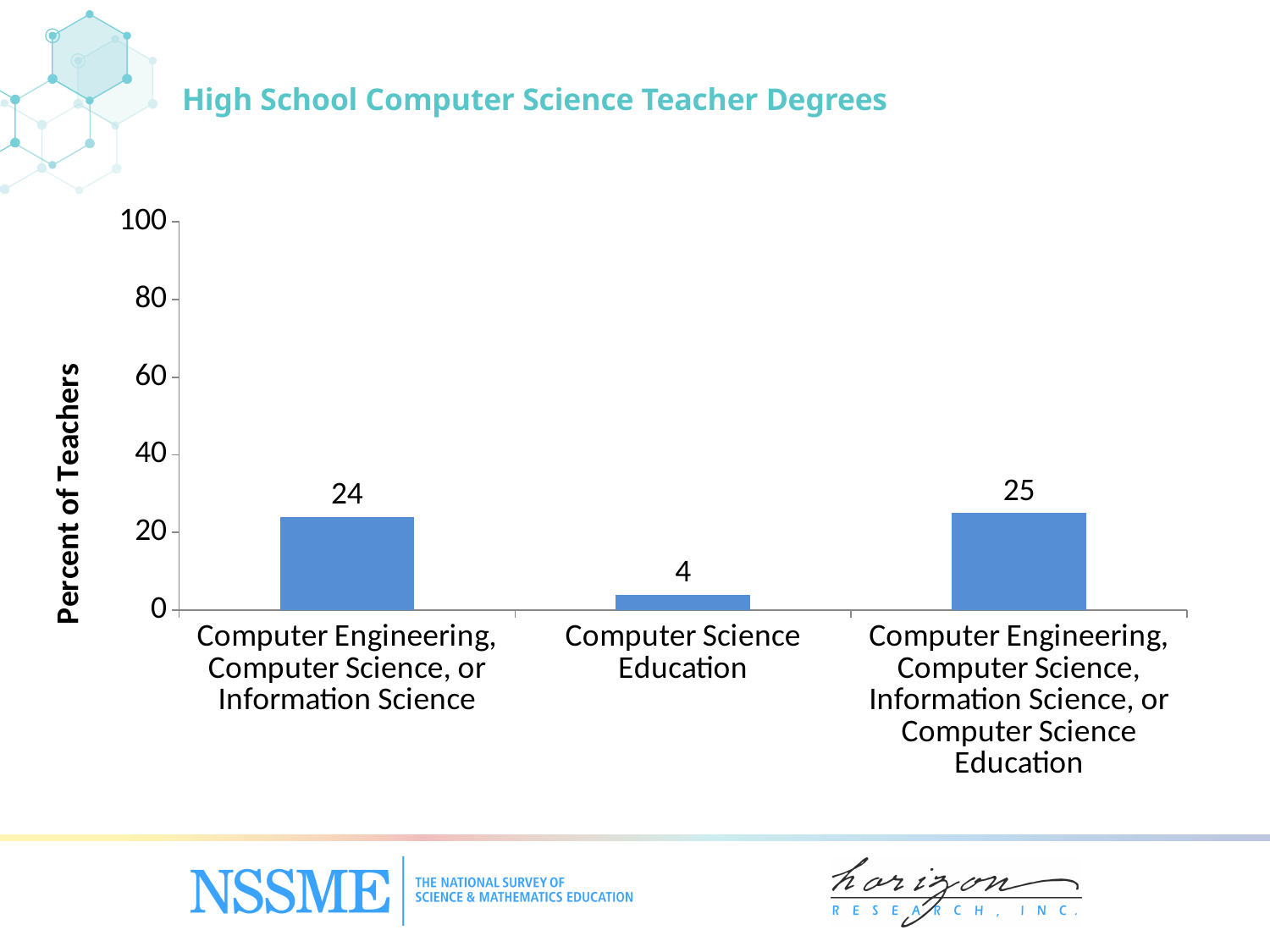
What is the difference in percent of teachers between the Computer Engineering, Computer Science, or Information Science category and the Computer Science Education category? 20 What is the label of the y axis? Percent of Teachers Which category has the lowest percent of teachers? Computer Science Education Is the value for Computer Engineering, Computer Science, Information Science, or Computer Science Education greater or less than 40? less What percent of teachers have a degree in Computer Engineering, Computer Science, or Information Science? 24 What kind of chart is shown on the slide? bar chart Which is larger: the value for Computer Science Education or the value for Computer Engineering, Computer Science, or Information Science? Computer Engineering, Computer Science, or Information Science What percent of teachers have a degree in Computer Engineering, Computer Science, Information Science, or Computer Science Education? 25 What percent of teachers have a degree in Computer Science Education? 4 What is the title of the chart? High School Computer Science Teacher Degrees Is the value for Computer Science Education greater or less than 20? less How many categories are shown on the x axis? 3